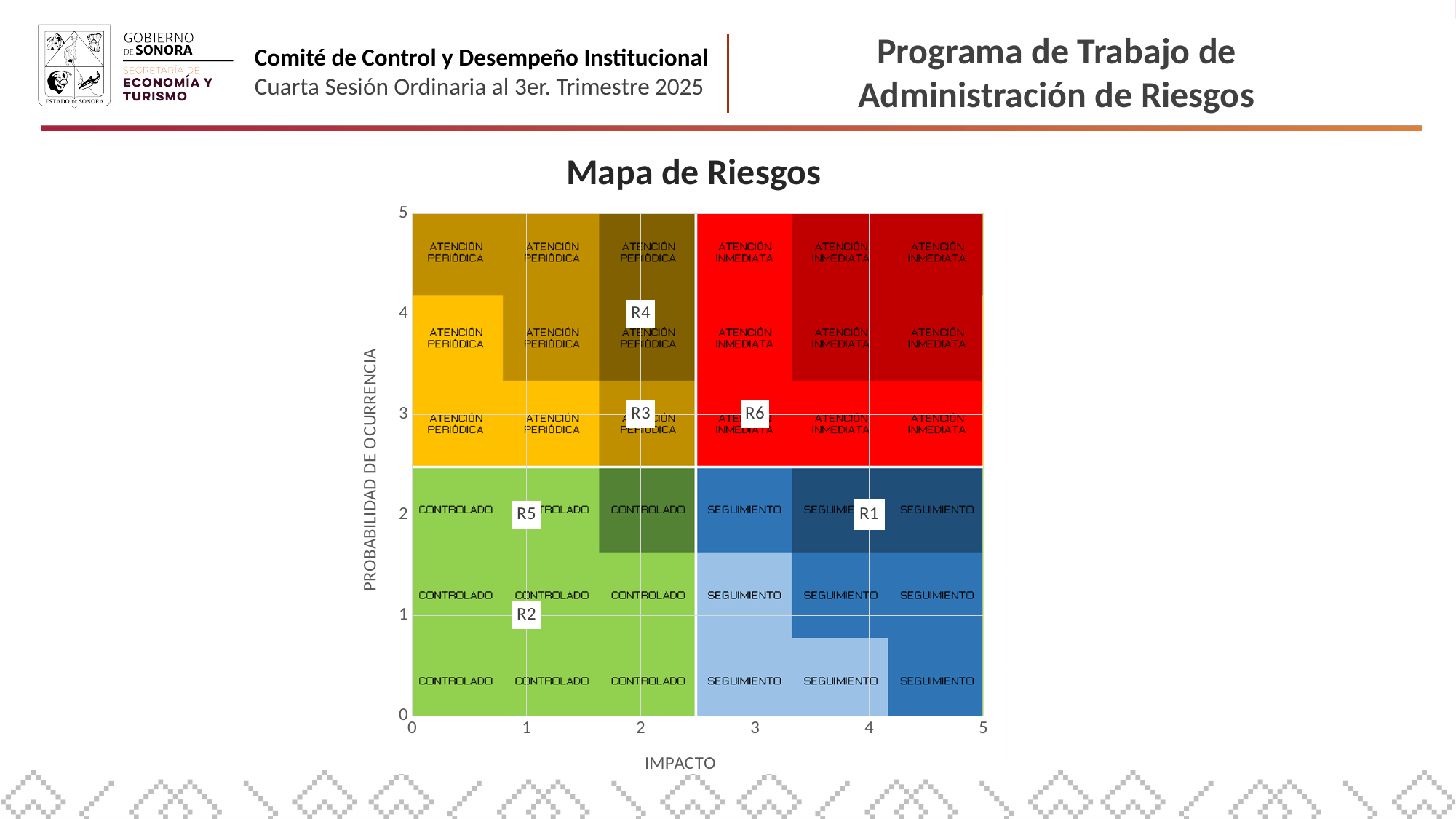
What is the title of the chart? Mapa de Riesgos What is the difference in IMPACTO between R1 and R5? 3 What is the label of the x axis? IMPACTO What is the IMPACTO value for R1? 4 What is the PROBABILIDAD DE OCURRENCIA value for R4? 4 What is the PROBABILIDAD DE OCURRENCIA value for R2? 1 Which risk point has the highest IMPACTO? R1 How many risk points (R labels) are plotted on the chart? 6 Which risk point has the highest PROBABILIDAD DE OCURRENCIA? R4 What kind of chart is shown on the slide? scatter chart Which risk point has the lowest PROBABILIDAD DE OCURRENCIA? R2 What is the IMPACTO value for R6? 3